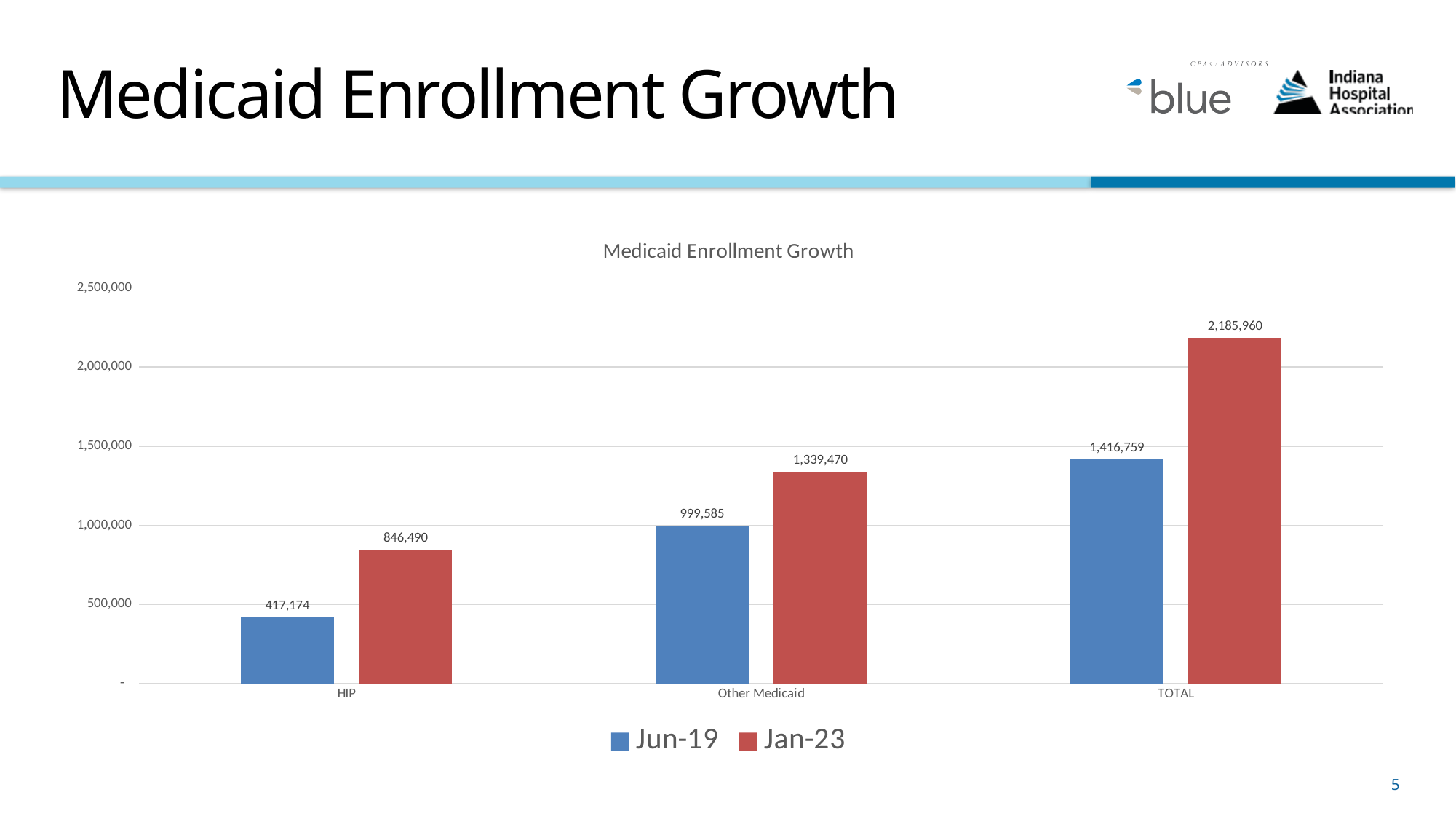
What is the Jan-23 value for Other Medicaid? 1,339,470 How many categories are shown on the x axis? 3 Which category has the highest Jan-23 value? TOTAL Which category has the lowest Jun-19 value? HIP What is the difference between the Jan-23 and Jun-19 values for TOTAL? 769,201 How many series does the legend list? 2 What is the Jun-19 value for TOTAL? 1,416,759 Which is larger for Other Medicaid, the Jun-19 value or the Jan-23 value? Jan-23 What is the difference between the Jan-23 and Jun-19 values for HIP? 429,316 What kind of chart is shown on the slide? Bar chart What is the Jan-23 value for TOTAL? 2,185,960 What is the Jun-19 value for HIP? 417,174